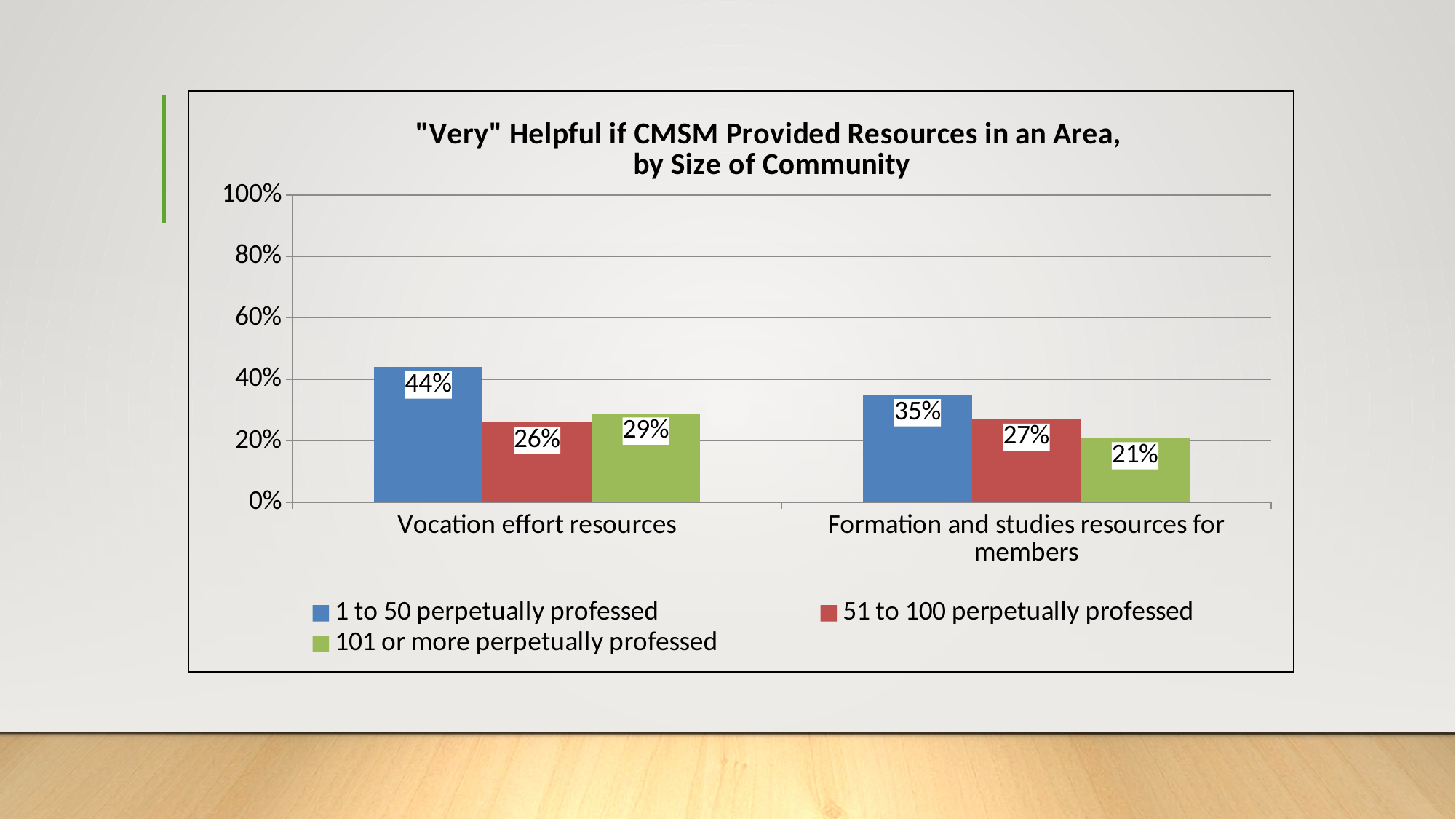
What is the value for 51 to 100 perpetually professed for vocation effort resources? 26% What is the value for 101 or more perpetually professed for formation and studies resources for members? 21% Is the value for 1 to 50 perpetually professed for vocation effort resources greater or less than 40%? greater What percentage of communities with 1 to 50 perpetually professed said vocation effort resources would be "very" helpful? 44% Which community size group has the lowest value for formation and studies resources for members? 101 or more perpetually professed Which community size group has the highest value for vocation effort resources? 1 to 50 perpetually professed What is the difference between the 1 to 50 perpetually professed values for vocation effort resources and formation and studies resources for members? 9% Which colour represents 51 to 100 perpetually professed in the chart? Red How many series does the legend list? 3 What kind of chart is shown on the slide? Bar chart For 101 or more perpetually professed, which area has the larger value: vocation effort resources or formation and studies resources for members? Vocation effort resources How many categories are shown on the x axis? 2